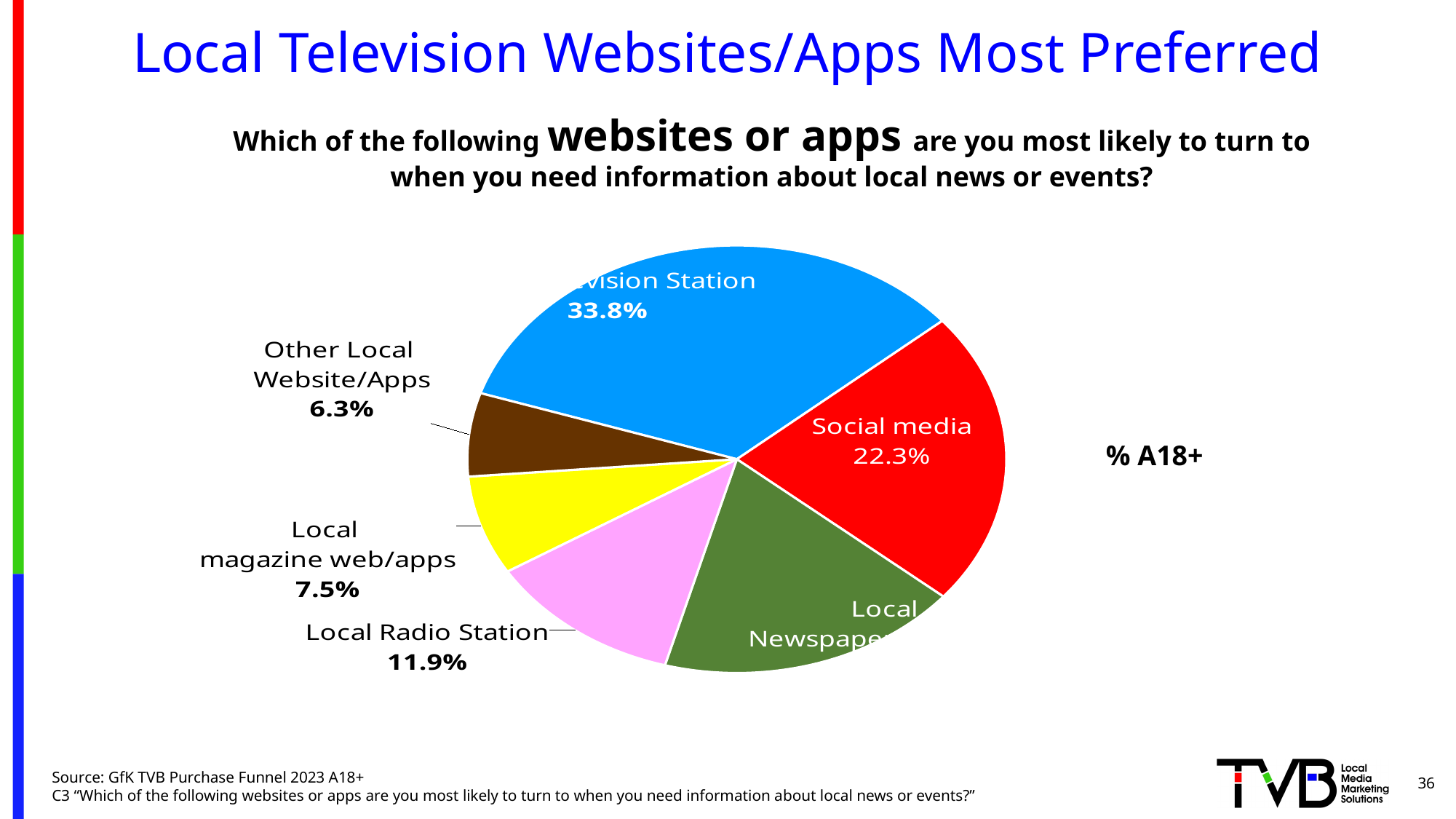
Which is larger, Local magazine web/apps or Other Local Website/Apps? Local magazine web/apps What percentage is shown for the Local Television Station slice? 33.8% How many percentage points higher is Social media than Local Radio Station? 10.4 percentage points What kind of chart is shown on the slide? pie chart Which category has the smallest slice of the pie? Other Local Website/Apps How many slices does the pie chart have? 6 Which category has the largest slice of the pie? Local Television Station What percentage of the pie is Social media? 22.3% What percentage is shown for Local Radio Station? 11.9% What percentage is shown for Local magazine web/apps? 7.5% What percentage is shown for Other Local Website/Apps? 6.3% What colour is the Social media slice? red